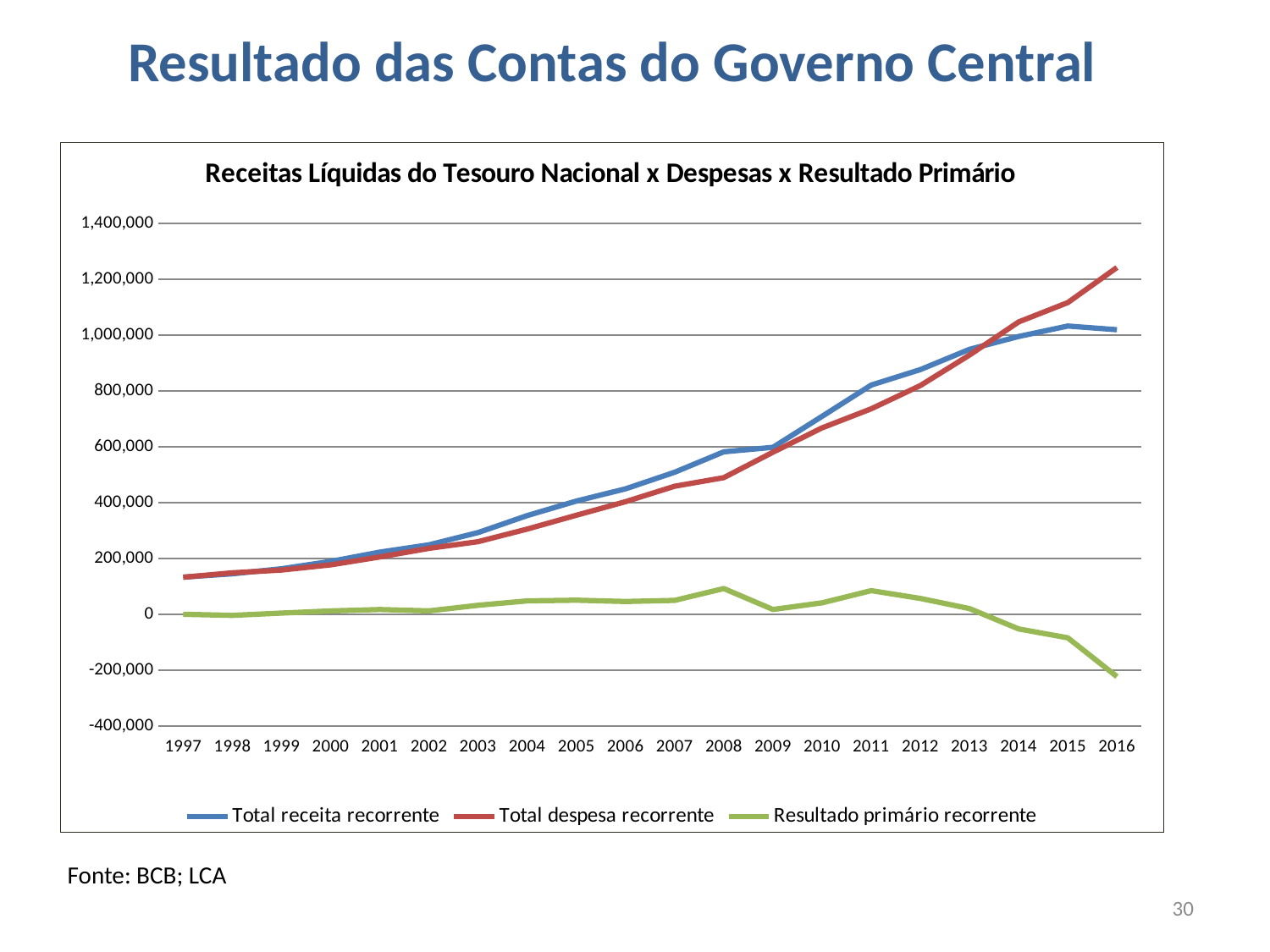
In which year does Total despesa recorrente reach its highest value? 2016 Is the value for Total receita recorrente in 2016 greater or less than 1,200,000? less Is the value for Resultado primário recorrente in 2016 greater or less than 0? less In 2008, which is larger, Total receita recorrente or Total despesa recorrente? Total receita recorrente In which year is Resultado primário recorrente at its lowest? 2016 What is the title of the chart? Receitas Líquidas do Tesouro Nacional x Despesas x Resultado Primário How many series does the legend list? 3 Is the value for Total receita recorrente in 2010 greater or less than 600,000? greater What kind of chart is shown on the slide? line chart How many years are shown on the x axis? 20 In 2016, which is larger, Total receita recorrente or Total despesa recorrente? Total despesa recorrente